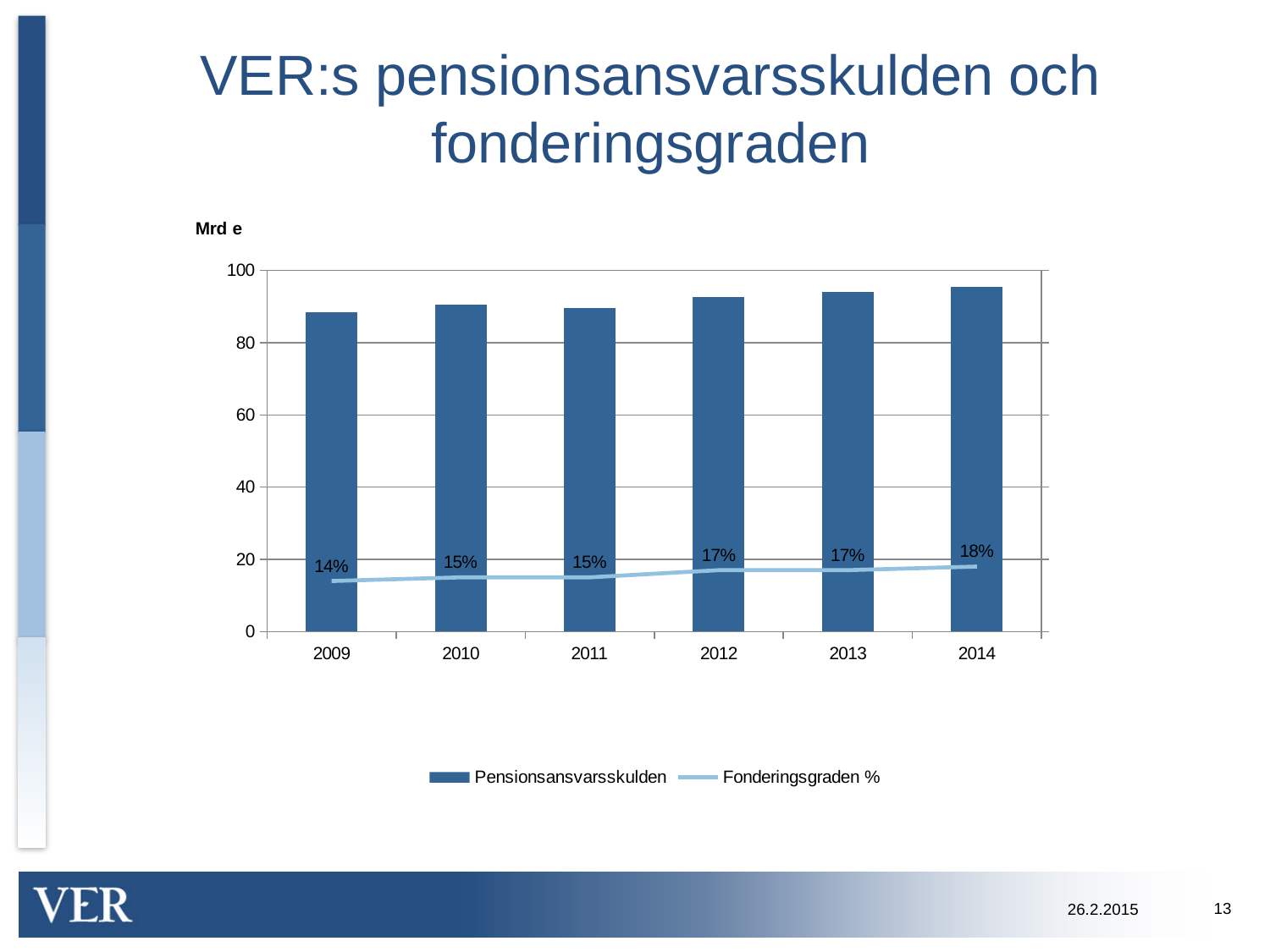
In which year is the Fonderingsgraden % lowest? 2009 By how many percentage points did the Fonderingsgraden % increase from 2009 to 2014? 4 percentage points Is the Pensionsansvarsskulden value for 2009 greater or less than 80? greater How many years are shown on the x axis? 6 What is the Fonderingsgraden % value for 2014? 18% Is the Pensionsansvarsskulden value for 2014 greater or less than 100? less Which year has a higher Fonderingsgraden %, 2010 or 2012? 2012 How many series does the legend list? 2 Does the Fonderingsgraden % rise or fall from 2009 to 2014? rise What is the Fonderingsgraden % value for 2012? 17% In which year is the Fonderingsgraden % highest? 2014 What is the Fonderingsgraden % value for 2009? 14%